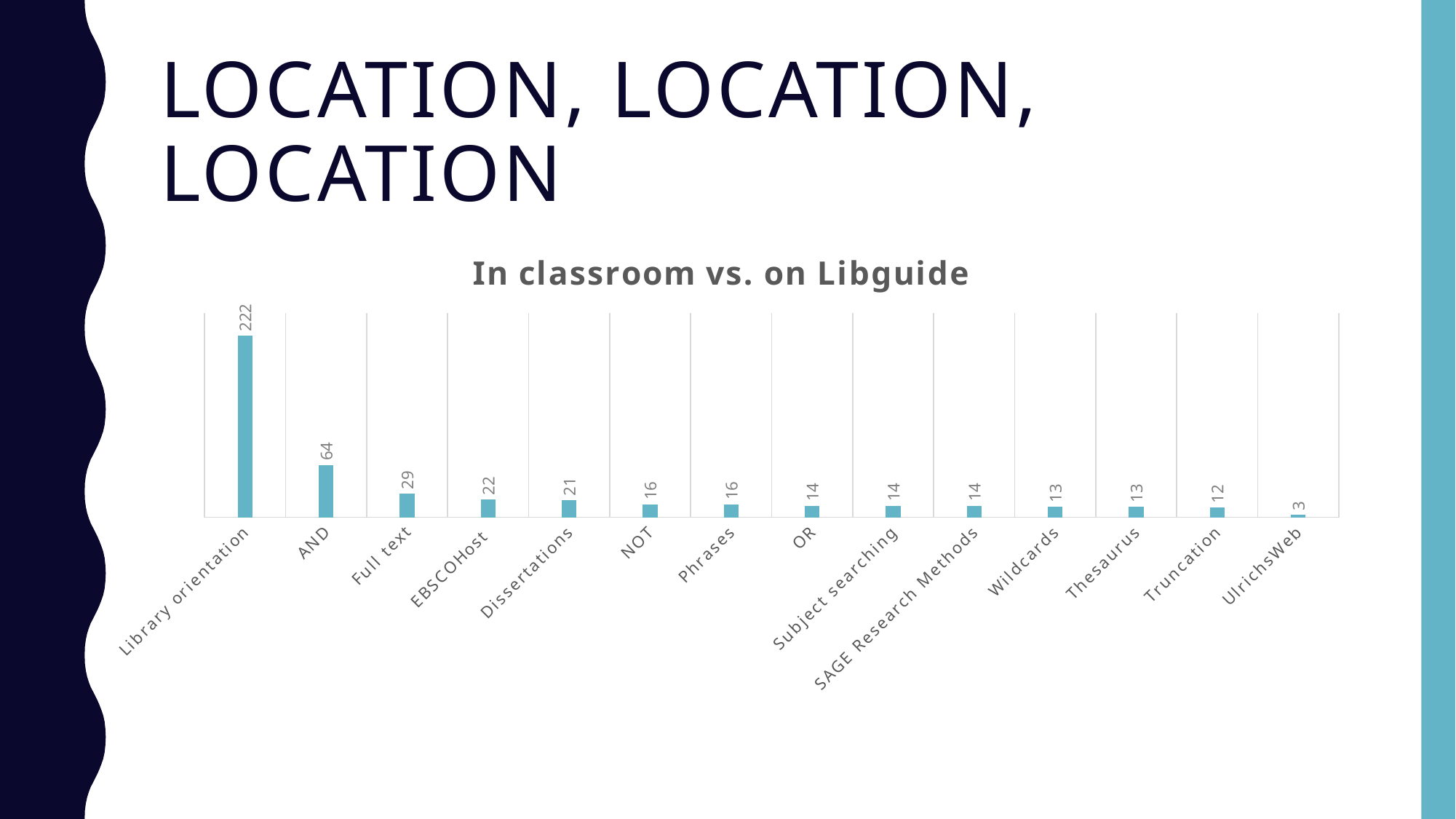
What is the value for EBSCOHost? 22 What is the title of the chart? In classroom vs. on Libguide Which category has the lowest value? UlrichsWeb What is the value for Thesaurus? 13 What is the value for Library orientation? 222 Which category has the highest value? Library orientation What is the difference between the values for Full text and Dissertations? 8 How many categories are shown in the chart? 14 What is the value for AND? 64 Which is larger, the value for NOT or the value for Truncation? NOT What is the difference between the values for Library orientation and AND? 158 What kind of chart is shown on the slide? Bar chart